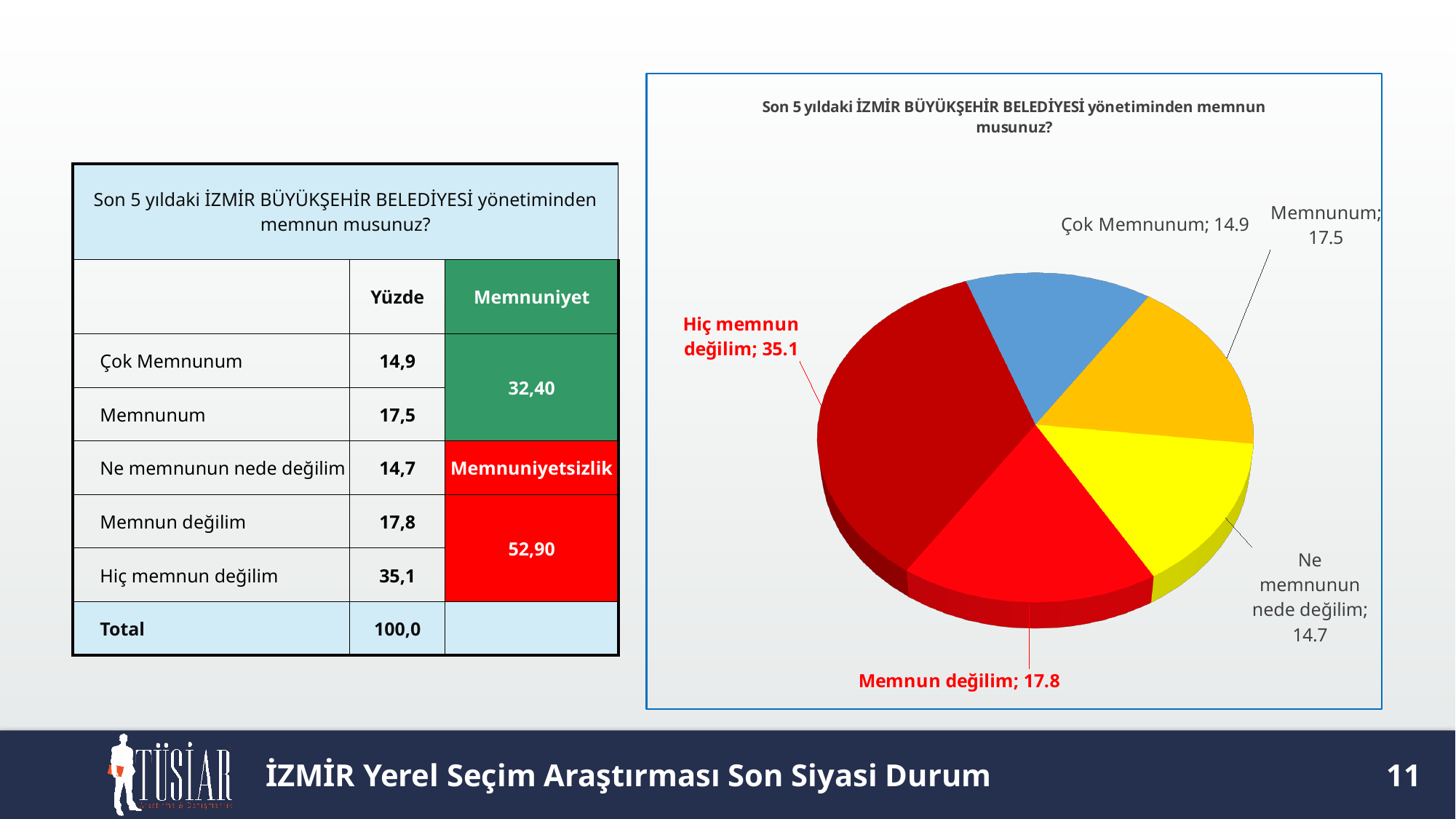
What is the value shown for "Memnun değilim" in the pie chart? 17.8 What is the value shown for "Memnunum" in the pie chart? 17.5 What is the value shown for "Çok Memnunum" in the pie chart? 14.9 How many slices does the pie chart have? 5 What colour is the "Hiç memnun değilim" slice in the pie chart? Dark red What is the value shown for "Ne memnunun nede değilim" in the pie chart? 14.7 Which is larger in the pie chart: the value for "Memnunum" or the value for "Çok Memnunum"? Memnunum Which category has the largest slice in the pie chart? Hiç memnun değilim What is the combined value of "Çok Memnunum" and "Memnunum" in the pie chart? 32.4 What type of chart is shown on the slide? Pie chart What is the difference between the values for "Hiç memnun değilim" and "Memnun değilim" in the pie chart? 17.3 What is the value shown for "Hiç memnun değilim" in the pie chart? 35.1